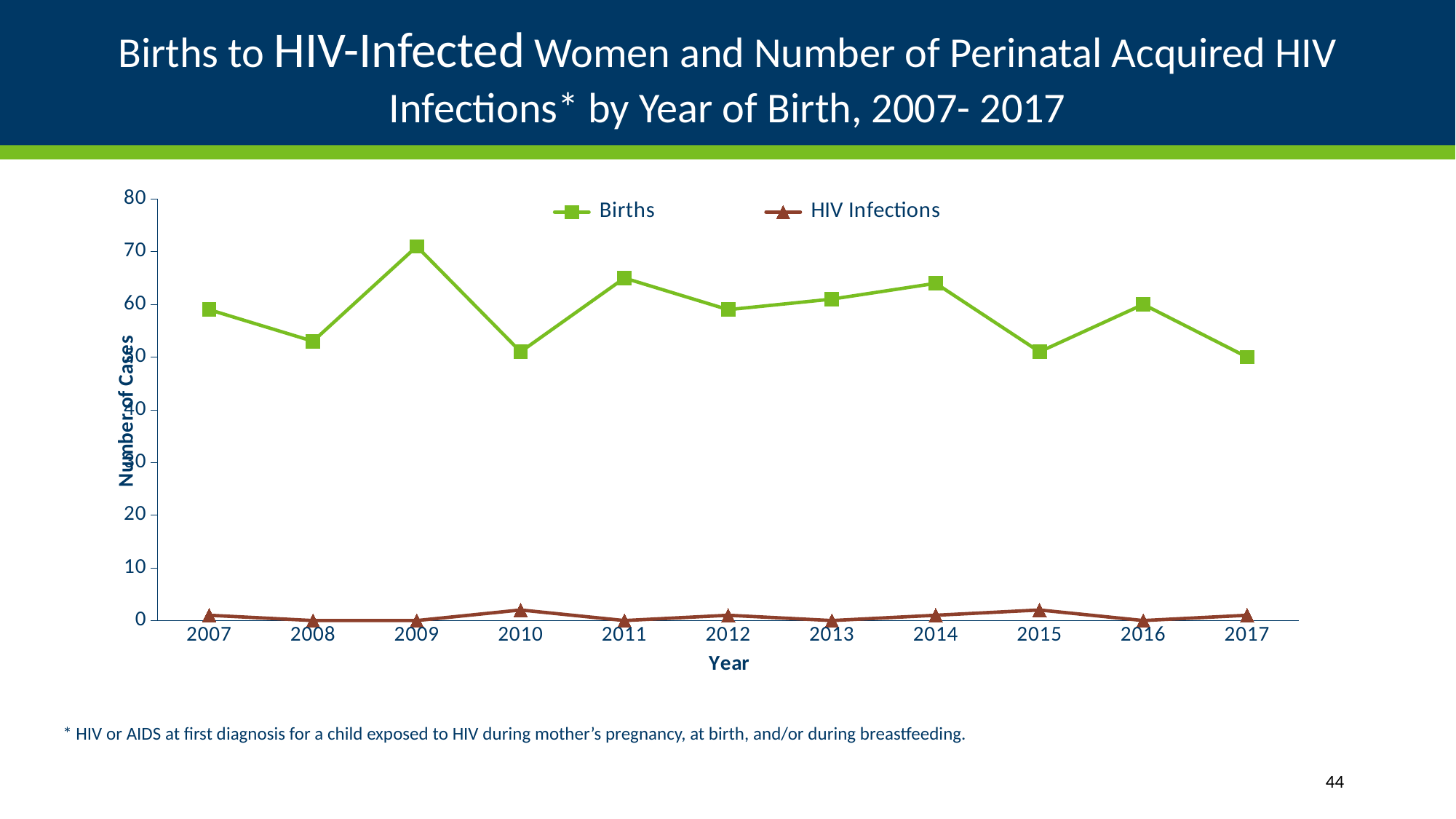
Is the value for Births in 2014 greater or less than 60? greater Is the value for Births in 2008 greater or less than 60? less Which is larger, Births in 2009 or Births in 2008? 2009 Is the value for Births in 2009 greater or less than 60? greater What kind of chart is shown on the slide? line chart How many years are plotted along the x axis? 11 Do Births rise or fall from 2014 to 2015? fall How many series does the legend list? 2 In which year were Births highest? 2009 What is the value for HIV Infections in 2008? 0 What is the title of the y axis? Number of Cases